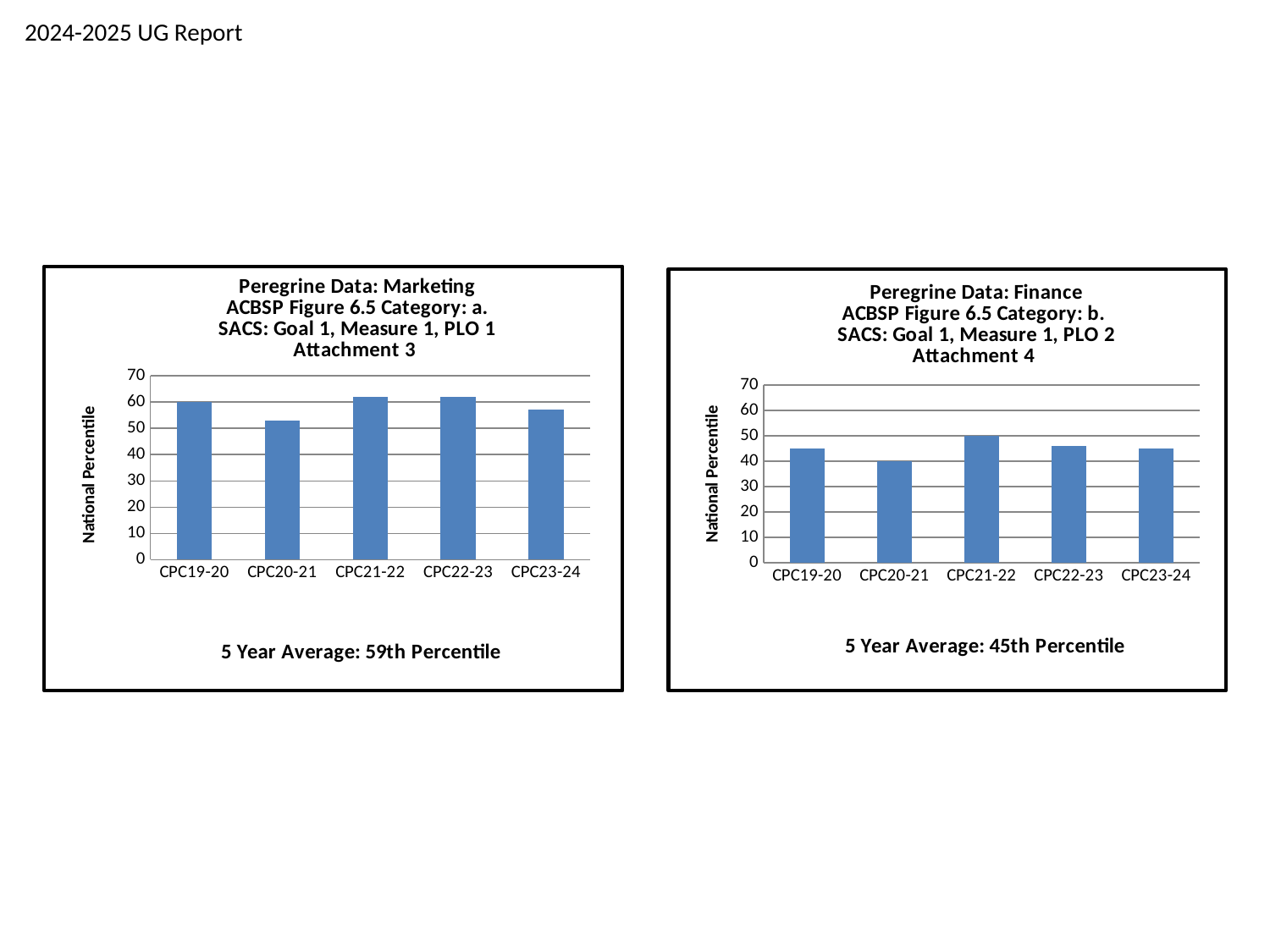
In the Peregrine Data: Finance chart, is the value for CPC22-23 greater or less than 50? less In the Peregrine Data: Finance chart, which category has the lowest value? CPC20-21 In the Peregrine Data: Marketing chart, which category has the lowest value? CPC20-21 What kind of chart is the Peregrine Data: Marketing chart? bar chart In the Peregrine Data: Marketing chart, is the value for CPC21-22 greater or less than 60? greater In the Peregrine Data: Marketing chart, is the value for CPC23-24 greater or less than 60? less In the Peregrine Data: Finance chart, which is larger, the value for CPC21-22 or CPC23-24? CPC21-22 In the Peregrine Data: Finance chart, which category has the highest value? CPC21-22 How many categories are shown on the x axis of the Peregrine Data: Finance chart? 5 What 5 year average is stated below the Peregrine Data: Finance chart? 45th Percentile In the Peregrine Data: Marketing chart, which is larger, the value for CPC19-20 or CPC20-21? CPC19-20